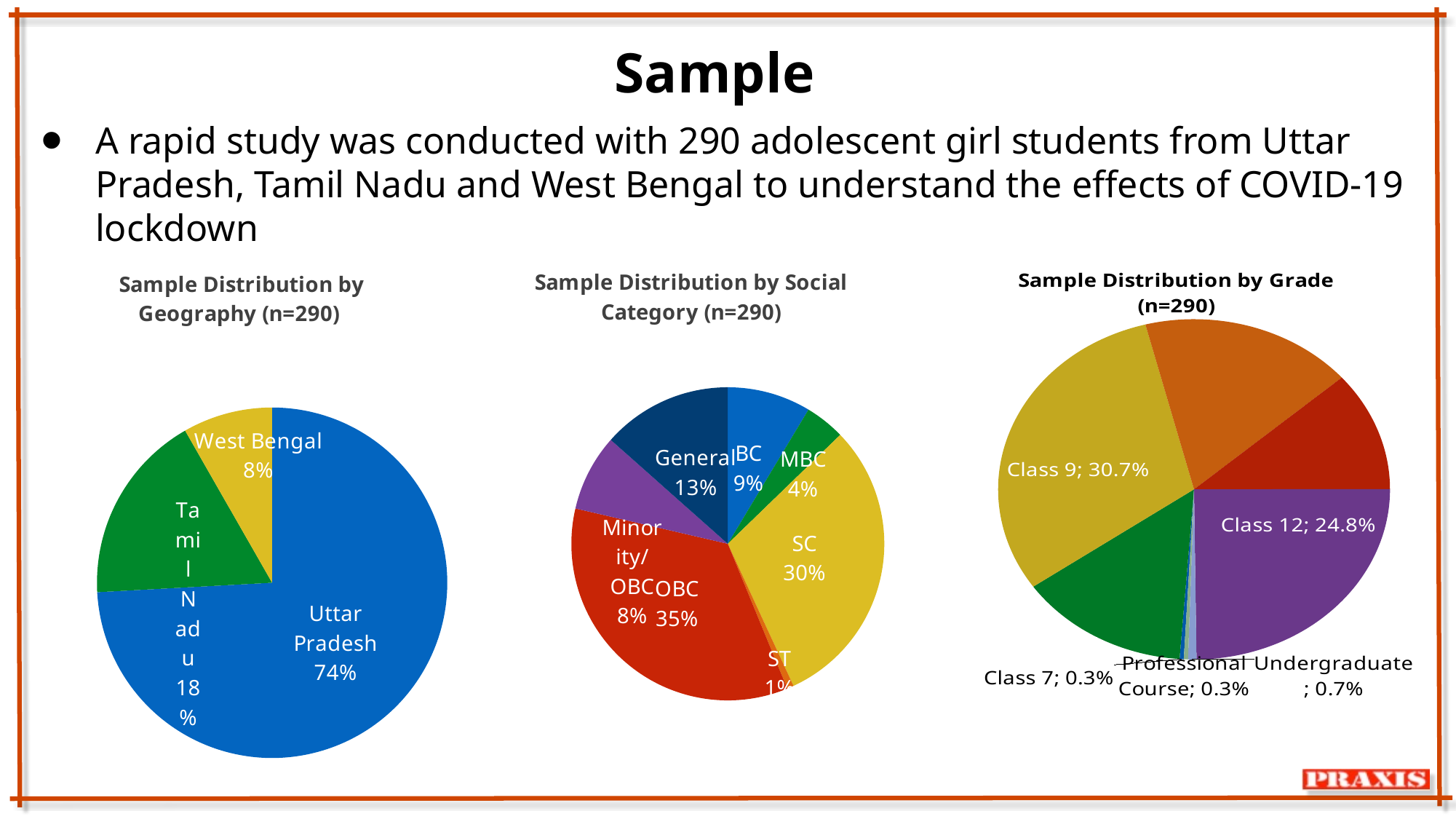
In the 'Sample Distribution by Social Category (n=290)' chart, what is the share for OBC? 35% In the 'Sample Distribution by Geography (n=290)' chart, how many percentage points larger is Tamil Nadu's share than West Bengal's? 10 percentage points In the 'Sample Distribution by Grade (n=290)' chart, what is the difference between the Class 9 and Class 12 shares? 5.9 percentage points In the 'Sample Distribution by Geography (n=290)' chart, which state has the smallest share? West Bengal In the 'Sample Distribution by Geography (n=290)' chart, which state has the largest share? Uttar Pradesh In the 'Sample Distribution by Grade (n=290)' chart, what is the share for Class 9? 30.7% In the 'Sample Distribution by Social Category (n=290)' chart, which category has the smallest share? ST How many slices does the 'Sample Distribution by Geography (n=290)' chart have? 3 In the 'Sample Distribution by Social Category (n=290)' chart, which is larger, General or BC? General In the 'Sample Distribution by Geography (n=290)' chart, what share of the sample is from Uttar Pradesh? 74% In the 'Sample Distribution by Social Category (n=290)' chart, which category has the largest share? OBC How many categories are shown in the 'Sample Distribution by Social Category (n=290)' chart? 7